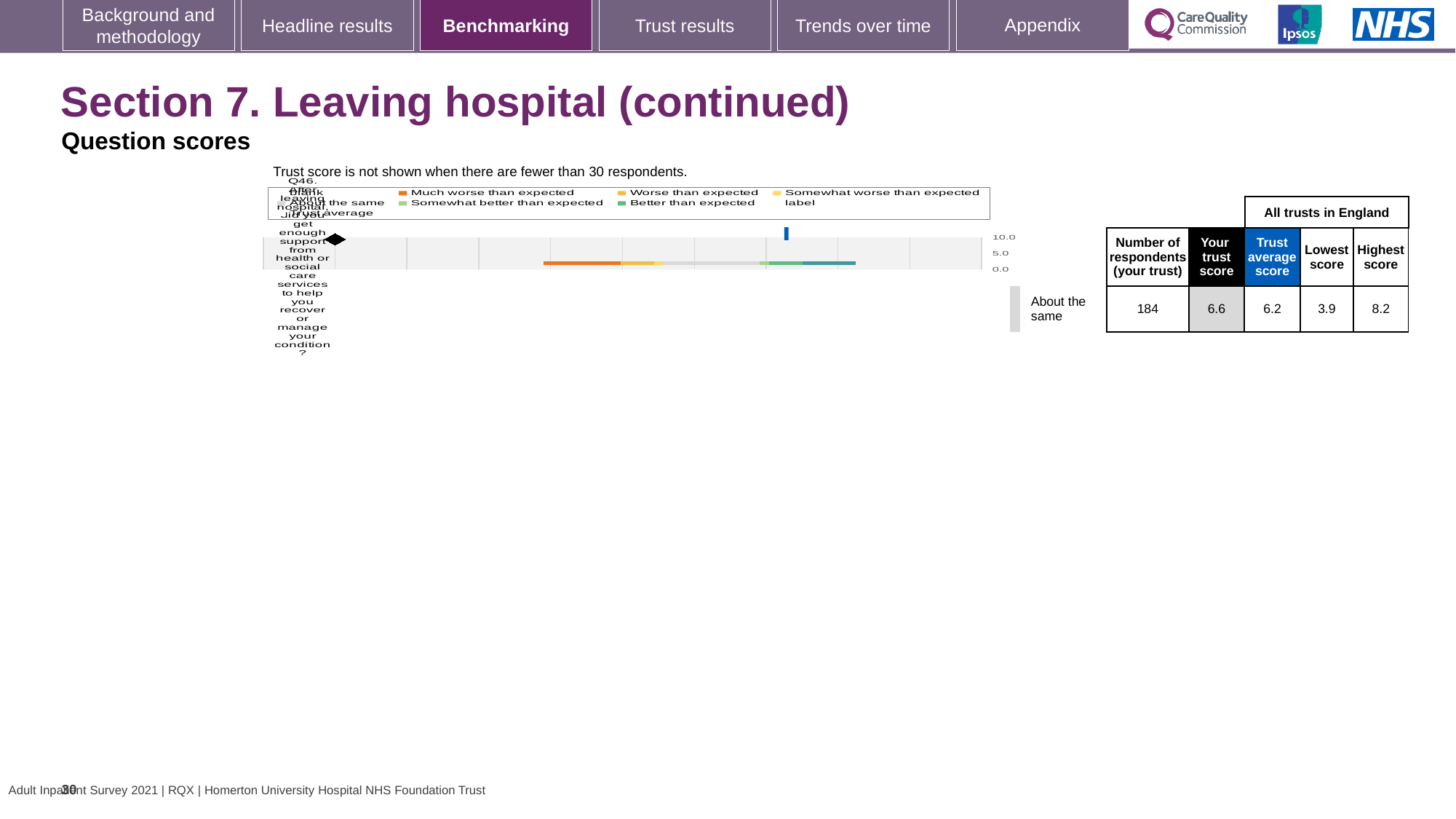
What is the lowest score among all trusts in England for Q46? 3.9 How many questions are plotted on the chart? 1 What is the difference between the trust score and the trust average score for Q46? 0.4 What is the trust average score across all trusts in England for Q46? 6.2 What kind of chart is used to show the Q46 score? Bar chart Is the trust score for Q46 greater or less than 5.0? greater What is the trust score for Q46 (support from health or social care services after leaving hospital)? 6.6 How many respondents from the trust answered Q46? 184 What is the highest score among all trusts in England for Q46? 8.2 Which is larger for Q46: the trust's own score or the trust average score? Your trust score How is the trust's Q46 score categorised relative to expectations? About the same What is the difference between the highest and lowest scores for Q46 across all trusts in England? 4.3